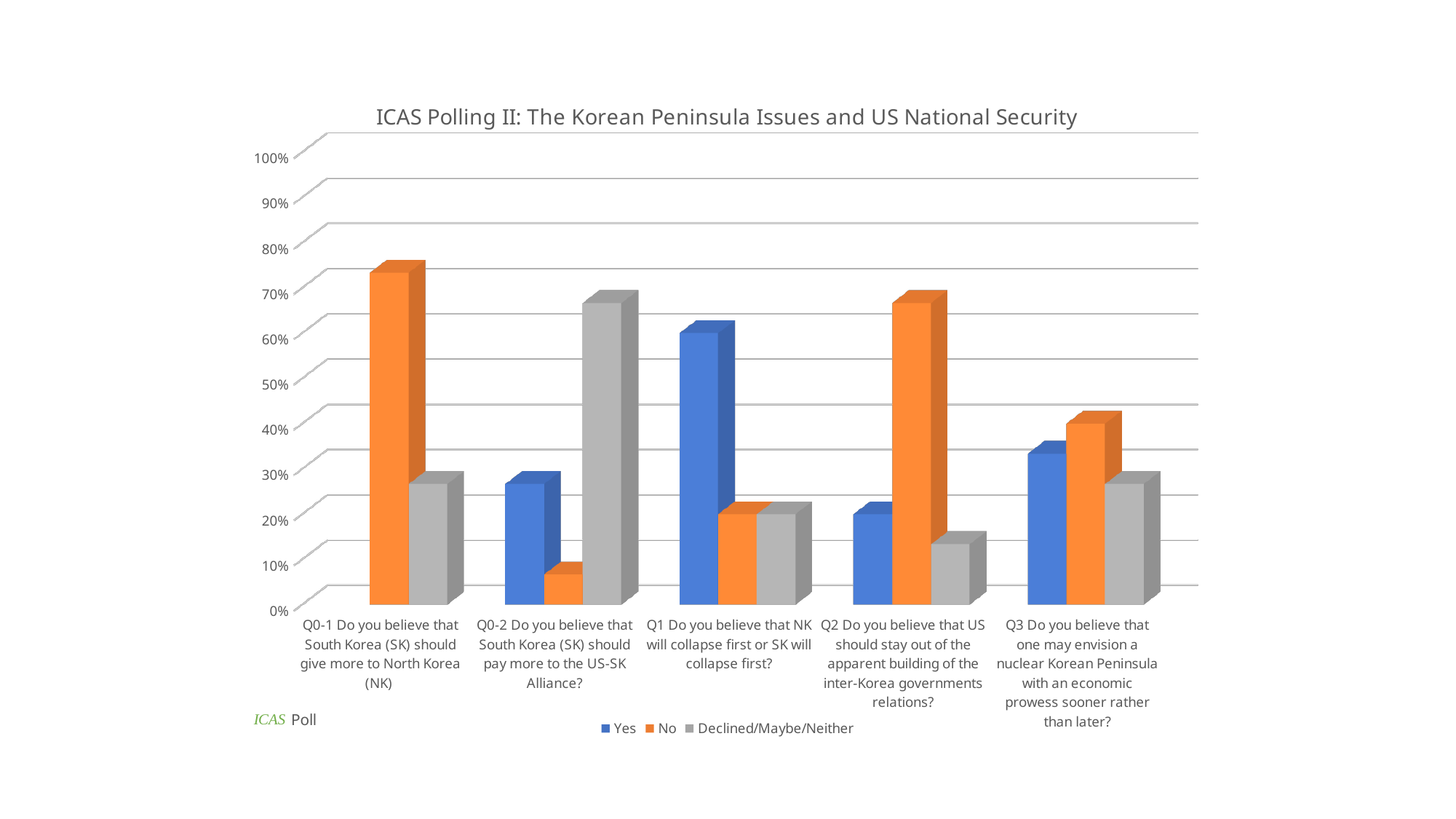
How many series does the legend list? 3 How many poll questions (categories) are shown along the x axis? 5 What is the title of the chart? ICAS Polling II: The Korean Peninsula Issues and US National Security Is the value for "No" on Q0-2 greater or less than 10%? less Which series is shown in orange in the legend? No Which response has the highest value for Q0-2? Declined/Maybe/Neither Is the value for "No" on Q0-1 greater or less than 60%? greater Is the value for "Yes" on Q1 greater or less than 50%? greater What kind of chart is shown on the slide? bar chart Which response has the lowest value for Q2? Declined/Maybe/Neither For Q3, which is larger, the "Yes" value or the "No" value? No